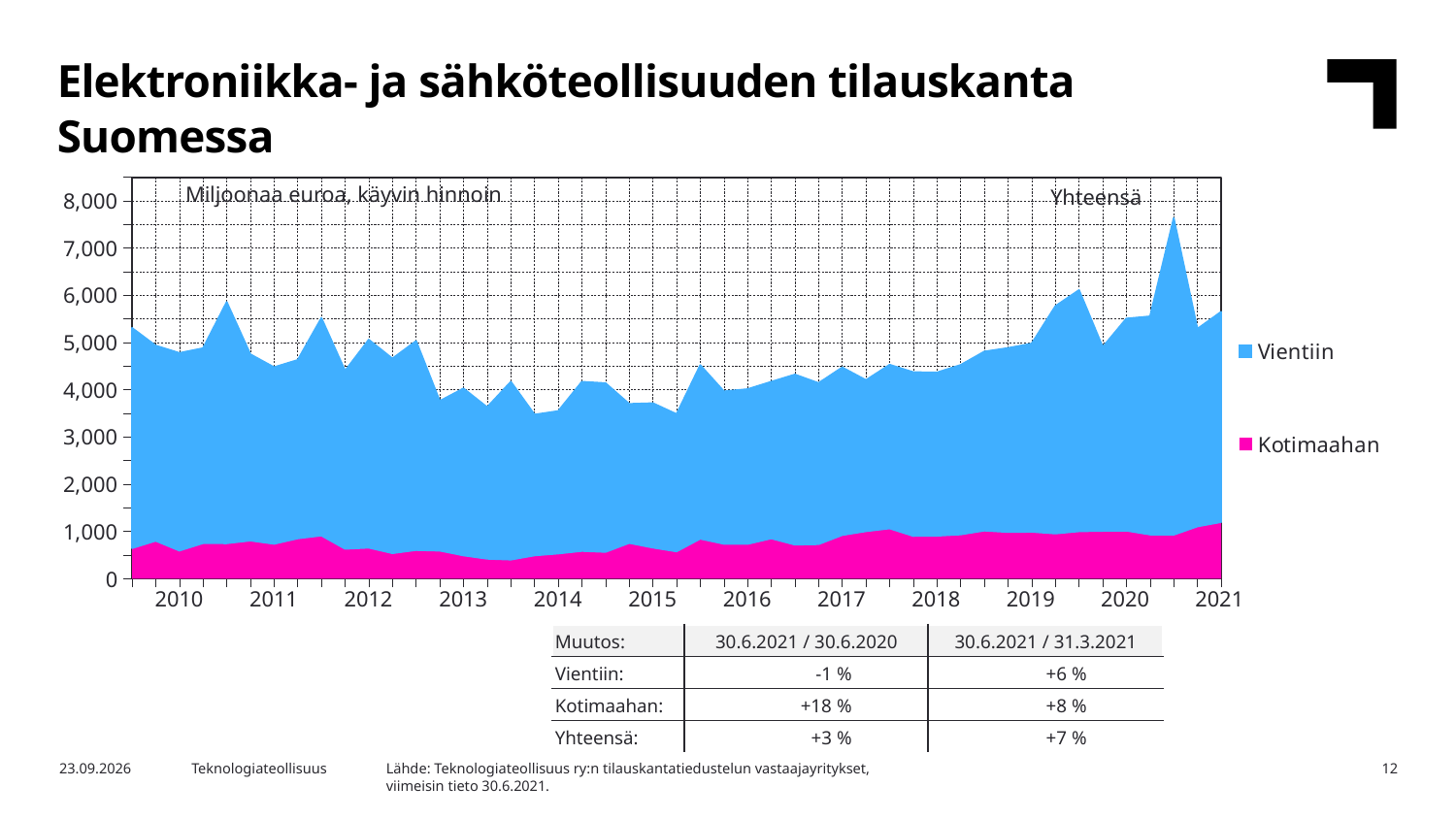
How many series does the chart legend list? 2 Which two series are listed in the chart legend? Vientiin and Kotimaahan Which series is larger throughout the chart, Vientiin or Kotimaahan? Vientiin What unit is stated in the label at the top left of the chart area? Miljoonaa euroa, käyvin hinnoin What kind of chart is shown on the slide? Area chart Does the total (Yhteensä) value rise or fall between 2010 and 2014? fall Is the Kotimaahan value in 2013 greater or less than 1,000? less Is the total (Yhteensä) value at the start of 2010 greater or less than 5,000? greater How many year labels are shown on the x axis? 12 Is the total (Yhteensä) value at the peak in 2020 greater or less than 7,000? greater Does the Kotimaahan series rise or fall between 2014 and 2021? rise